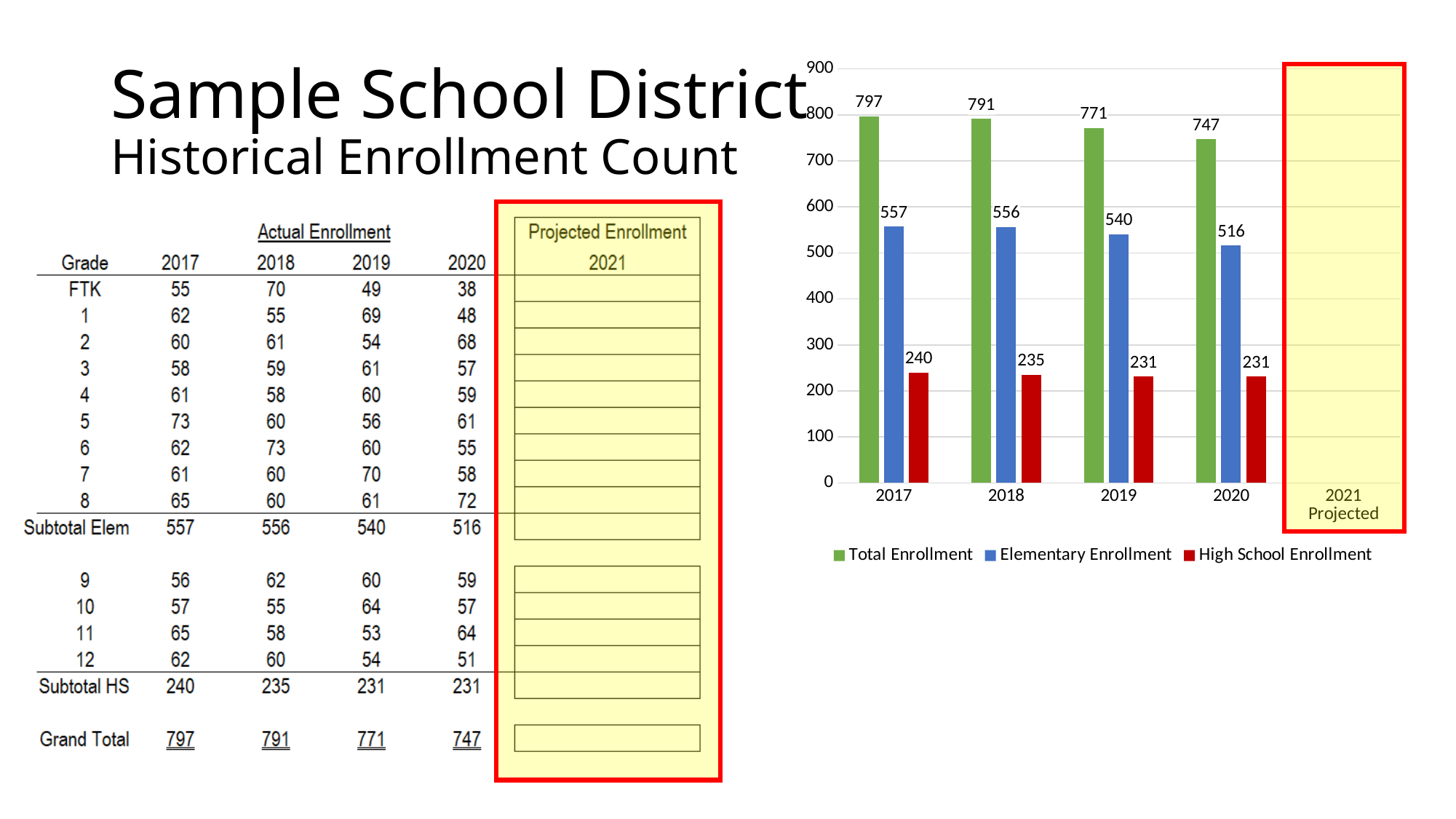
What colour are the High School Enrollment bars in the chart? Red What is the Elementary Enrollment value for 2019 in the chart? 540 What is the difference between Total Enrollment in 2017 and 2020 in the chart? 50 What is the High School Enrollment value for 2018 in the chart? 235 What is the Total Enrollment value for 2017 in the chart? 797 Which year has the lowest Total Enrollment in the chart? 2020 Is the Total Enrollment value for 2020 greater or less than 700? greater Does Total Enrollment rise or fall from 2017 to 2020 in the chart? Fall Which is larger in the chart: Elementary Enrollment in 2018 or Elementary Enrollment in 2020? Elementary Enrollment in 2018 Which year has the highest Elementary Enrollment in the chart? 2017 How many series does the chart legend list? 3 What kind of chart is shown on the slide? Bar chart